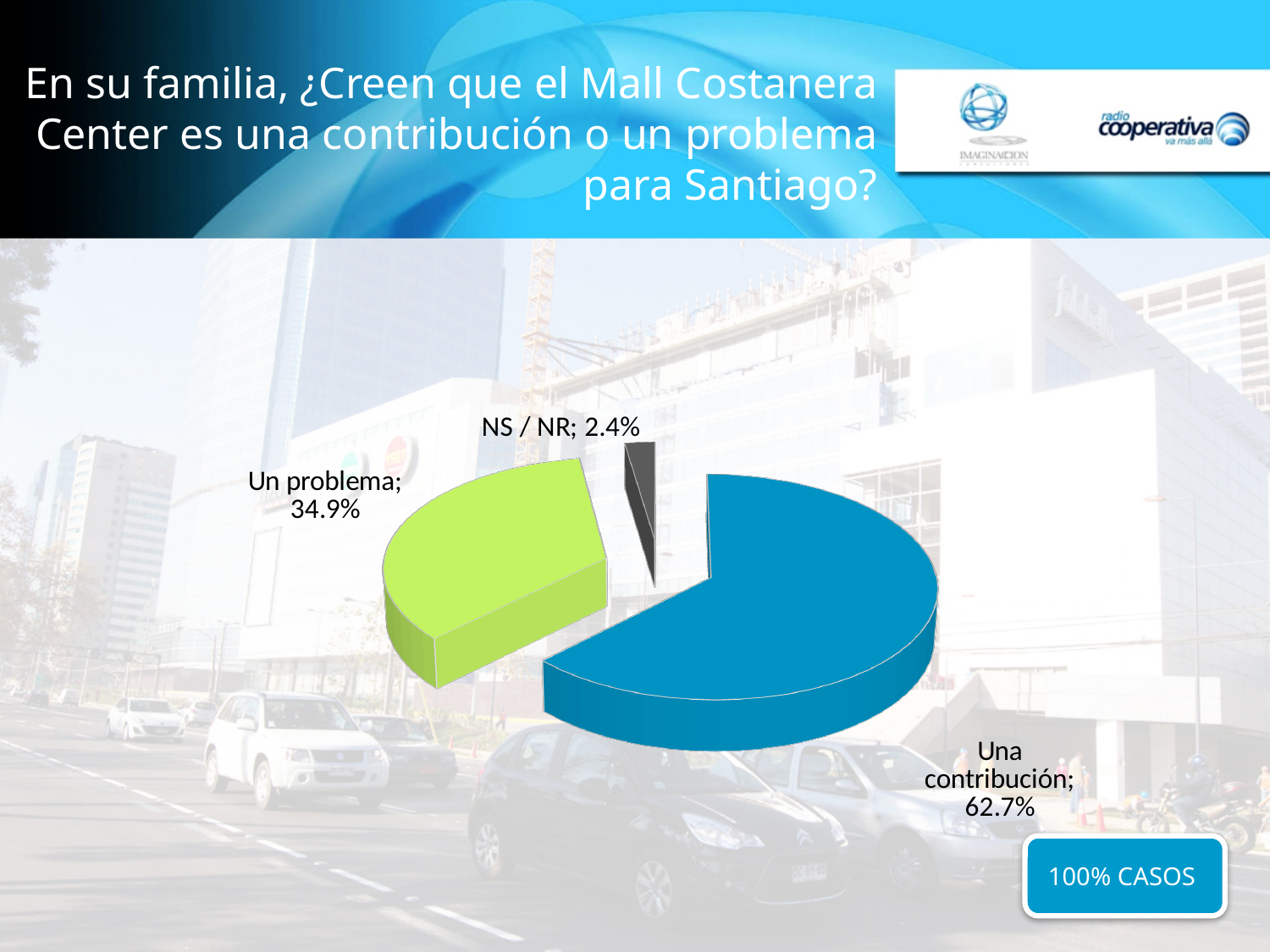
Which is larger, the share for "Un problema" or the share for "NS / NR"? Un problema What is the difference in percentage points between "Una contribución" and "Un problema"? 27.8 Which category has the largest share of the pie? Una contribución What colour is the "Un problema" slice? Green What percentage of respondents said the Mall Costanera Center is "Un problema"? 34.9% How many slices does the pie chart have? 3 What text appears in the box at the bottom right of the slide? 100% CASOS What percentage of respondents said the Mall Costanera Center is "Una contribución"? 62.7% Which category has the smallest share of the pie? NS / NR What percentage is shown for the "NS / NR" slice? 2.4% Is the share for "Una contribución" greater or less than 50%? greater What kind of chart is shown on the slide? Pie chart